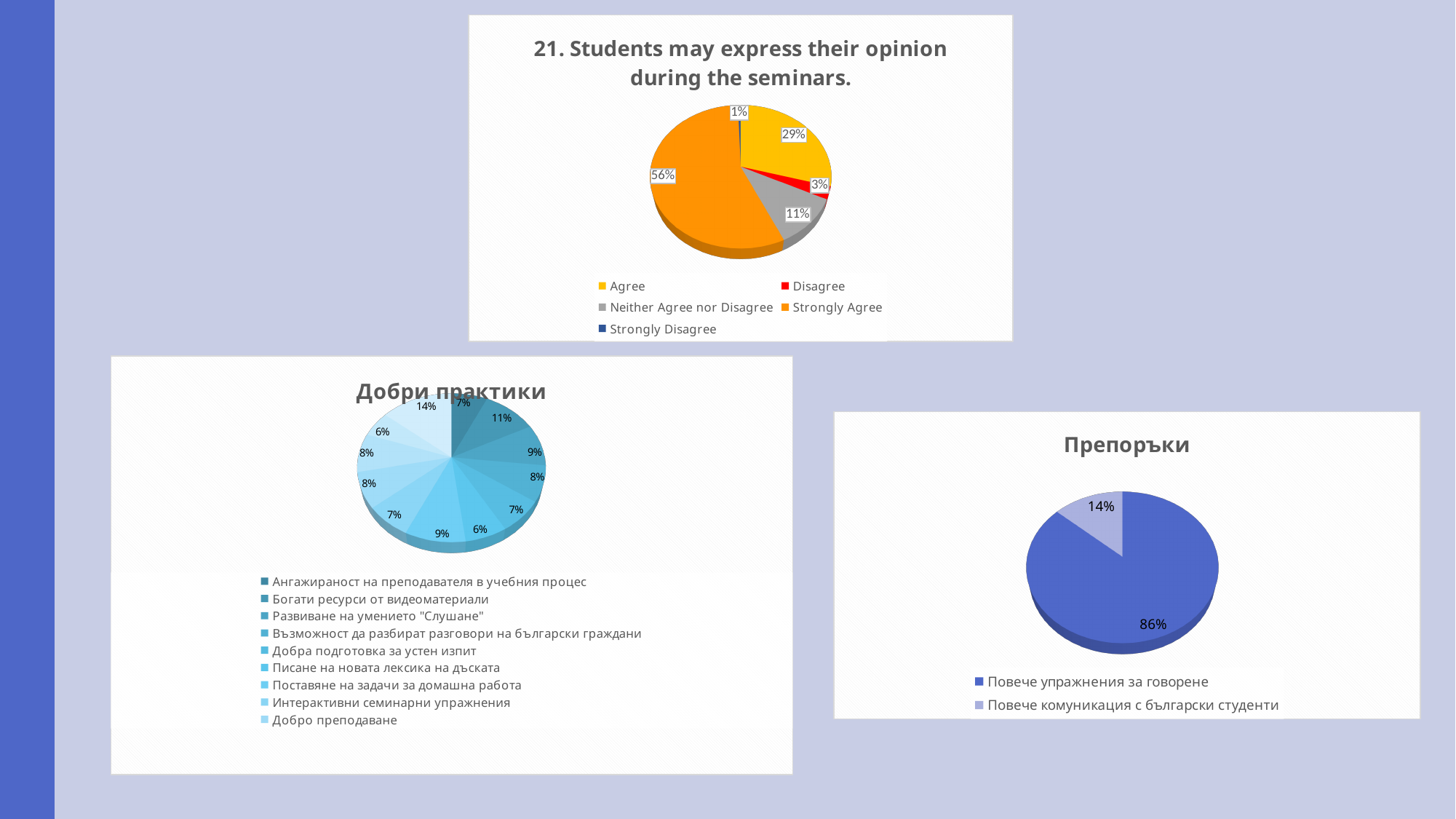
In the chart titled "21. Students may express their opinion during the seminars.", which response category has the smallest share? Strongly Disagree In the chart titled "Добри практики", how many entries does the legend list? 9 In the chart titled "21. Students may express their opinion during the seminars.", how many percentage points larger is Strongly Agree than Agree? 27 In the chart titled "21. Students may express their opinion during the seminars.", what share of responses is Strongly Agree? 56% In the chart titled "Препоръки", what share is "Повече комуникация с български студенти"? 14% In the chart titled "21. Students may express their opinion during the seminars.", how many categories does the legend list? 5 What kind of chart is the one titled "Препоръки"? Pie chart In the chart titled "Добри практики", what is the largest percentage shown on any slice? 14% In the chart titled "21. Students may express their opinion during the seminars.", what share of responses is Agree? 29% In the chart titled "21. Students may express their opinion during the seminars.", which response category has the largest share? Strongly Agree In the chart titled "Препоръки", what share is "Повече упражнения за говорене"? 86% In the chart titled "21. Students may express their opinion during the seminars.", what share of responses is Neither Agree nor Disagree? 11%